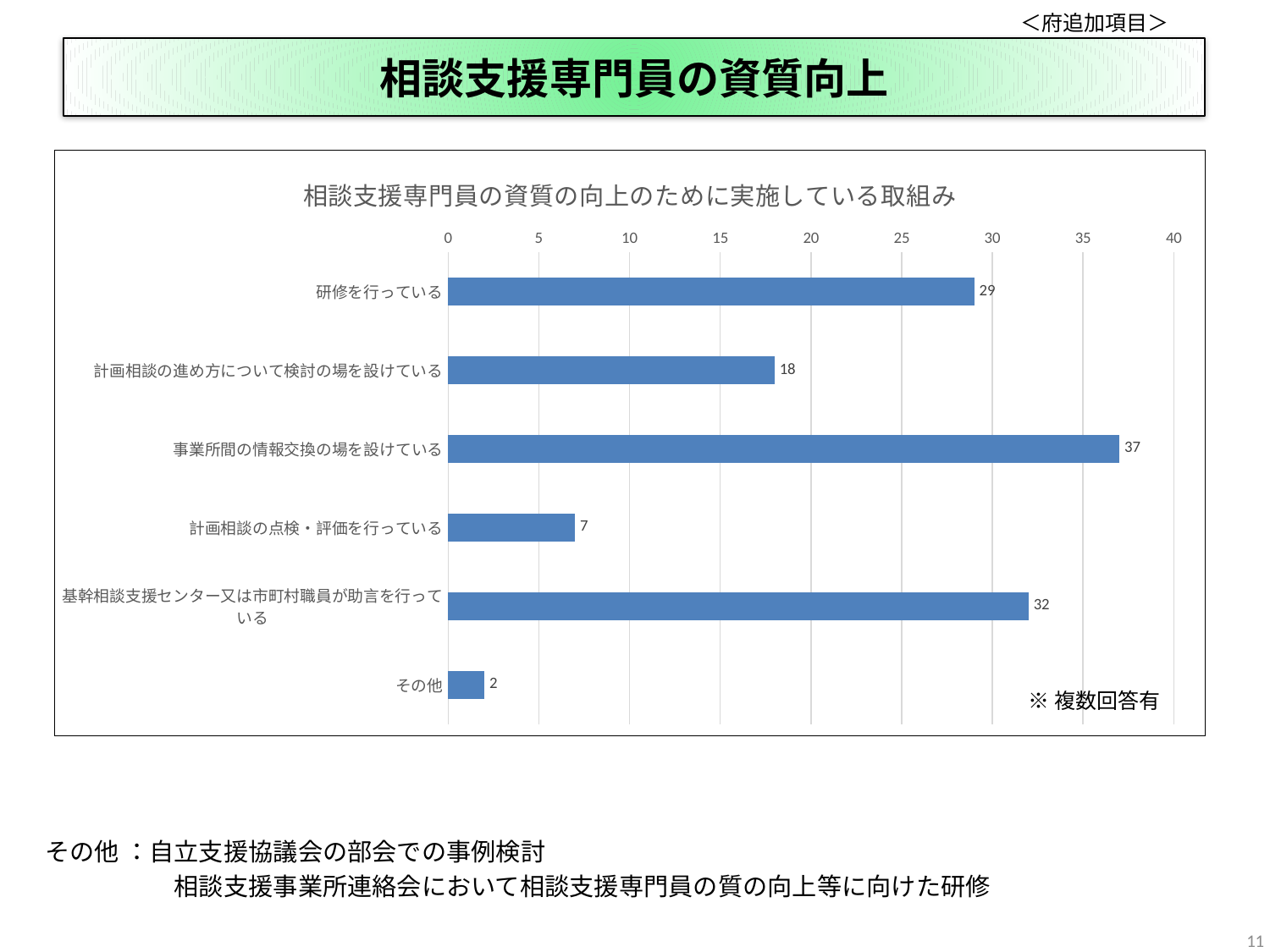
Which category has the lowest value? その他 Which category has the highest value? 事業所間の情報交換の場を設けている What is the value for その他? 2 What is the title of the chart? 相談支援専門員の資質の向上のために実施している取組み What is the value for 研修を行っている? 29 How many categories are shown in the chart? 6 Is the value for 基幹相談支援センター又は市町村職員が助言を行っている greater or less than 30? greater Which is larger, the value for 研修を行っている or the value for 計画相談の進め方について検討の場を設けている? 研修を行っている What is the value for 事業所間の情報交換の場を設けている? 37 What kind of chart is shown on the slide? bar chart What is the value for 計画相談の点検・評価を行っている? 7 What is the difference between the values for 事業所間の情報交換の場を設けている and 基幹相談支援センター又は市町村職員が助言を行っている? 5